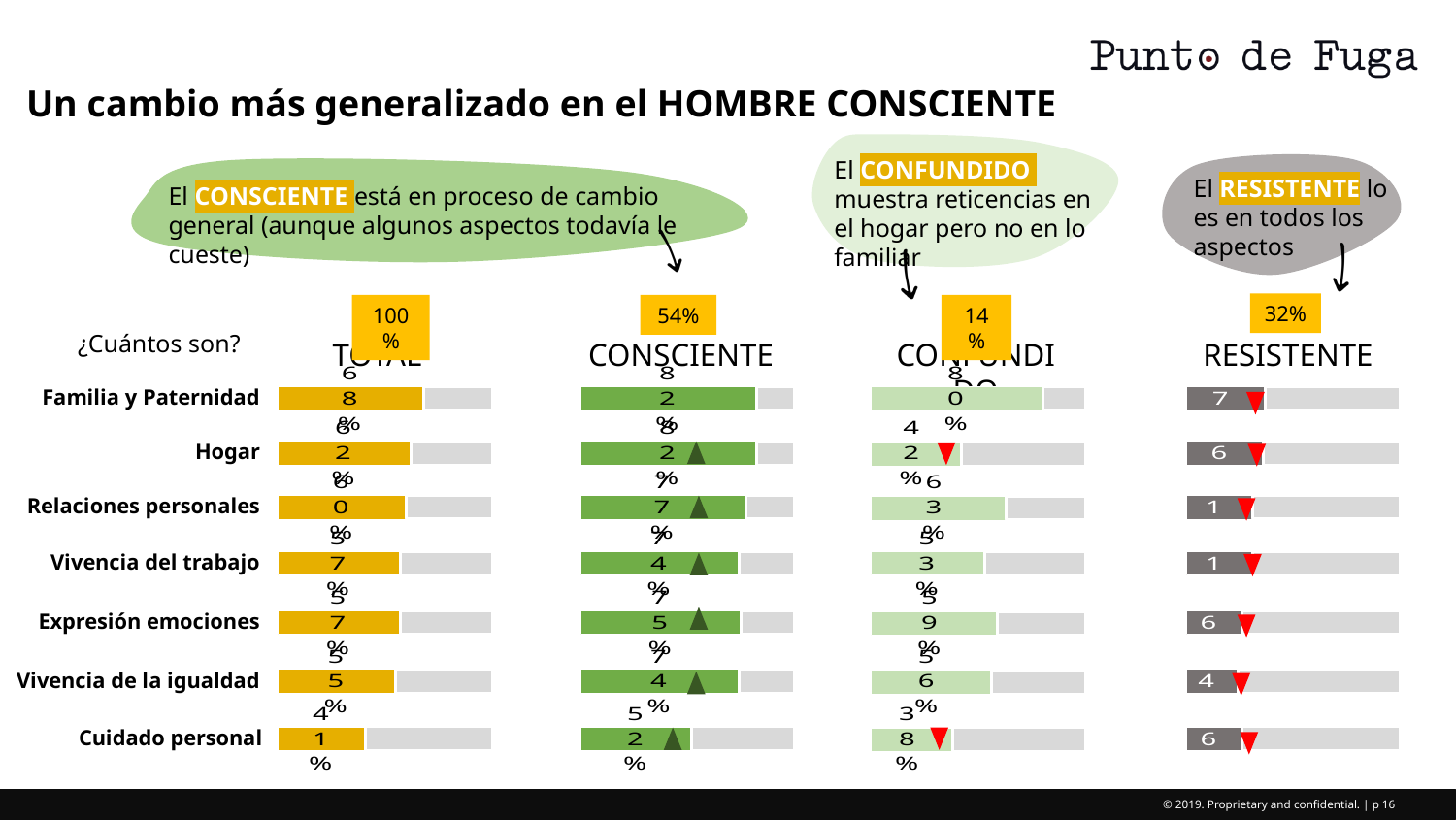
What percentage is shown above the RESISTENTE chart? 32% In the CONSCIENTE chart, which category has the shortest bar? Cuidado personal What percentage is shown above the CONSCIENTE chart in answer to "¿Cuántos son?"? 54% In the RESISTENTE chart, which bar is longer: Familia y Paternidad or Relaciones personales? Familia y Paternidad In the TOTAL chart, which category has the shortest bar? Cuidado personal In the CONFUNDIDO chart, which category has the longest bar? Familia y Paternidad By how many percentage points does the share shown above CONSCIENTE (54%) exceed the share shown above RESISTENTE (32%)? 22 percentage points What kind of chart is used for the TOTAL, CONSCIENTE, CONFUNDIDO and RESISTENTE groups? Bar chart What percentage is shown above the CONFUNDIDO chart? 14% What percentage is shown above the TOTAL chart? 100% How many categories (rows) are plotted in each of the bar charts? 7